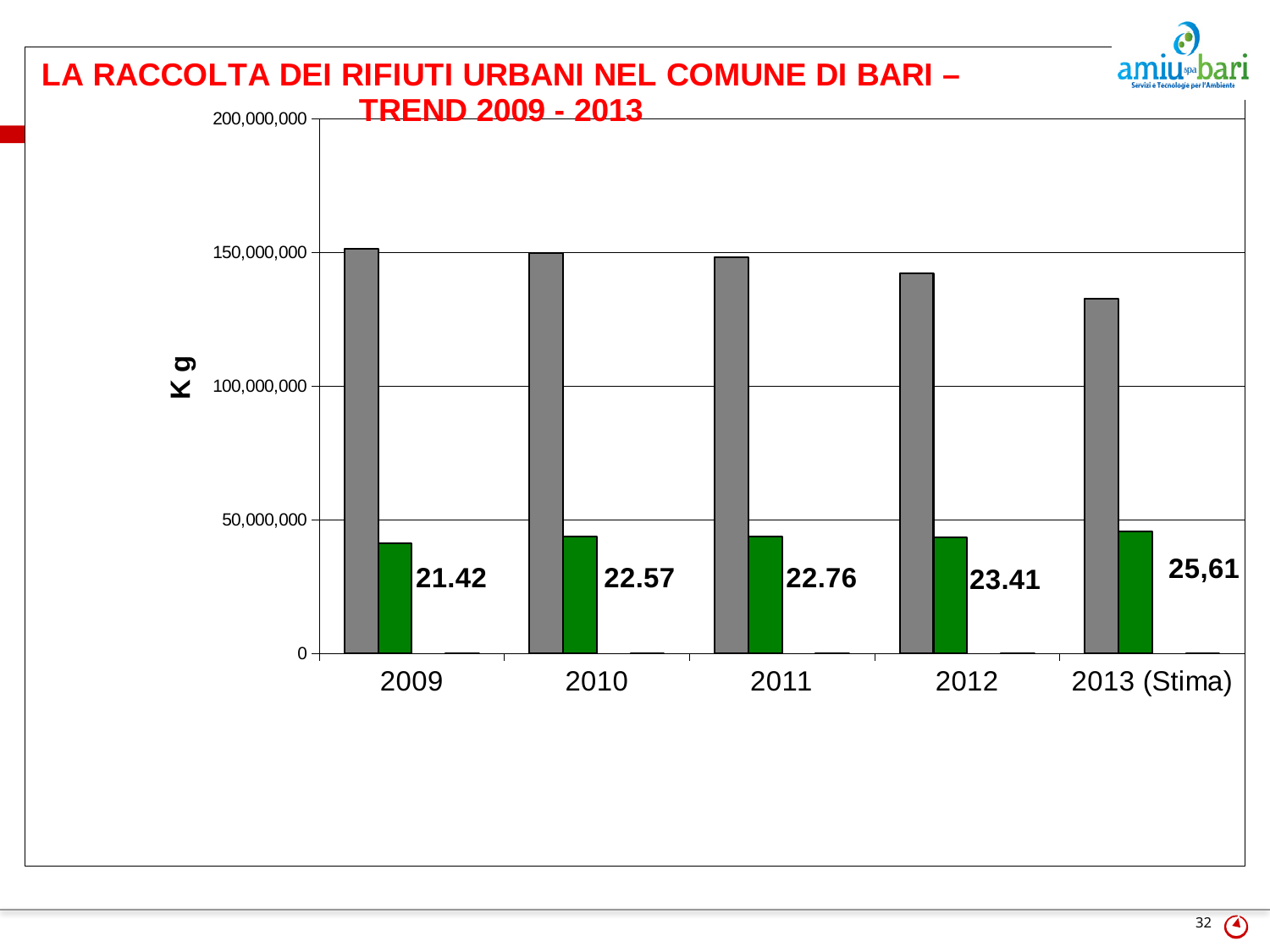
Which year has the highest printed data label? 2013 (Stima) What data label is printed next to the green bar for 2011? 22.76 What unit is shown on the y axis label? K g What kind of chart is shown on the slide? bar chart Which year has the lowest printed data label? 2009 Do the gray bars rise or fall from 2009 to 2013 (Stima)? fall Is the gray bar for 2013 (Stima) greater or less than 150,000,000? less What data label is printed next to the green bar for 2013 (Stima)? 25,61 How many year categories are shown on the x axis? 5 What is the title of the chart? LA RACCOLTA DEI RIFIUTI URBANI NEL COMUNE DI BARI – TREND 2009 - 2013 Which gray bar is taller, 2009 or 2013 (Stima)? 2009 What is the difference between the printed data labels for 2012 and 2009? 1.99